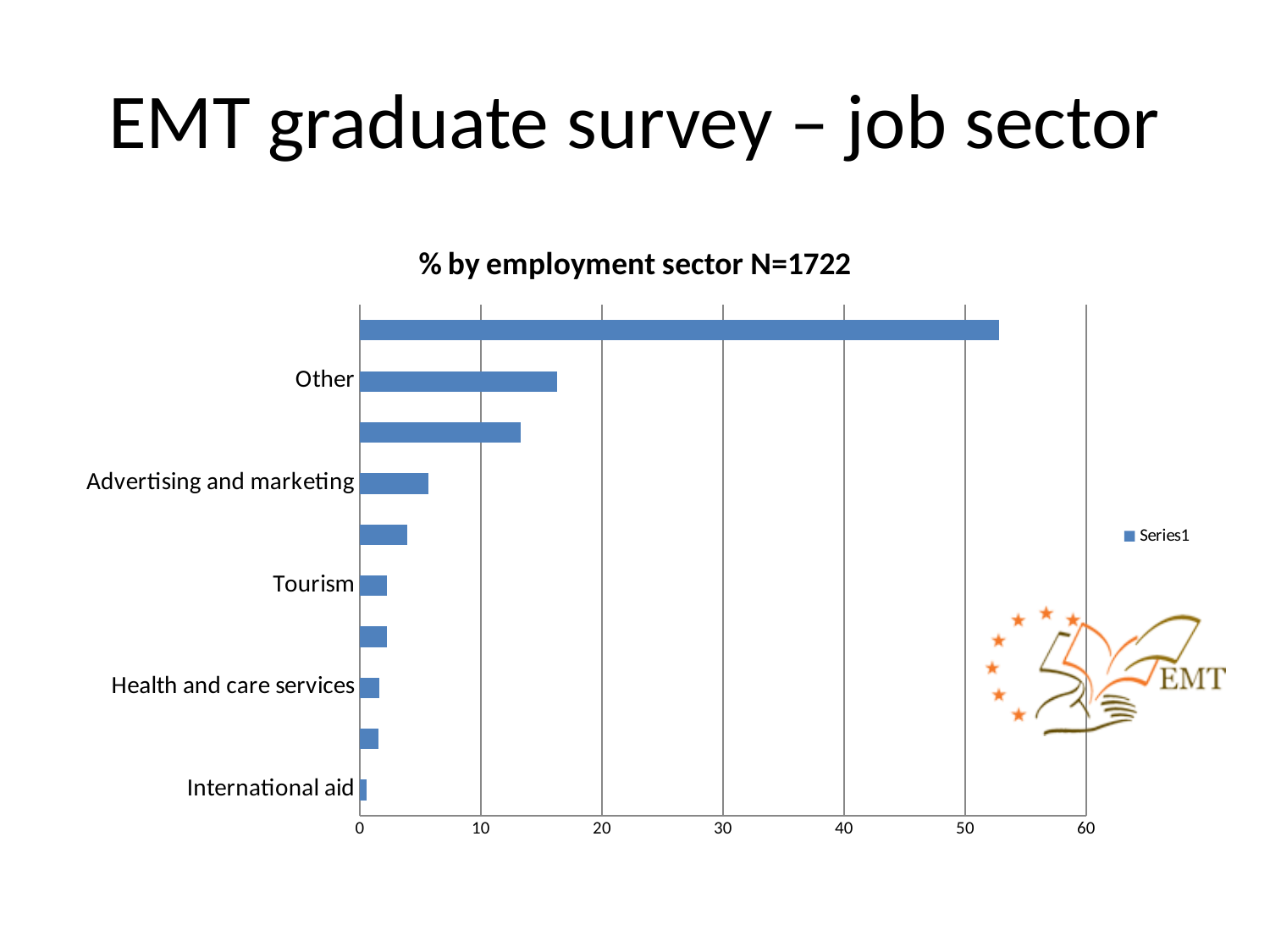
What kind of chart is shown on the slide? bar chart What is the title of the chart? % by employment sector N=1722 Is the value for Tourism greater or less than 10? less What is the name of the series shown in the legend? Series1 Is the value for Other greater or less than 10? greater How many bars are plotted in the chart? 10 Is the value for Advertising and marketing greater or less than 10? less Which is larger, the value for Other or the value for Advertising and marketing? Other How many series does the legend list? 1 Which labelled category has the lowest value? International aid